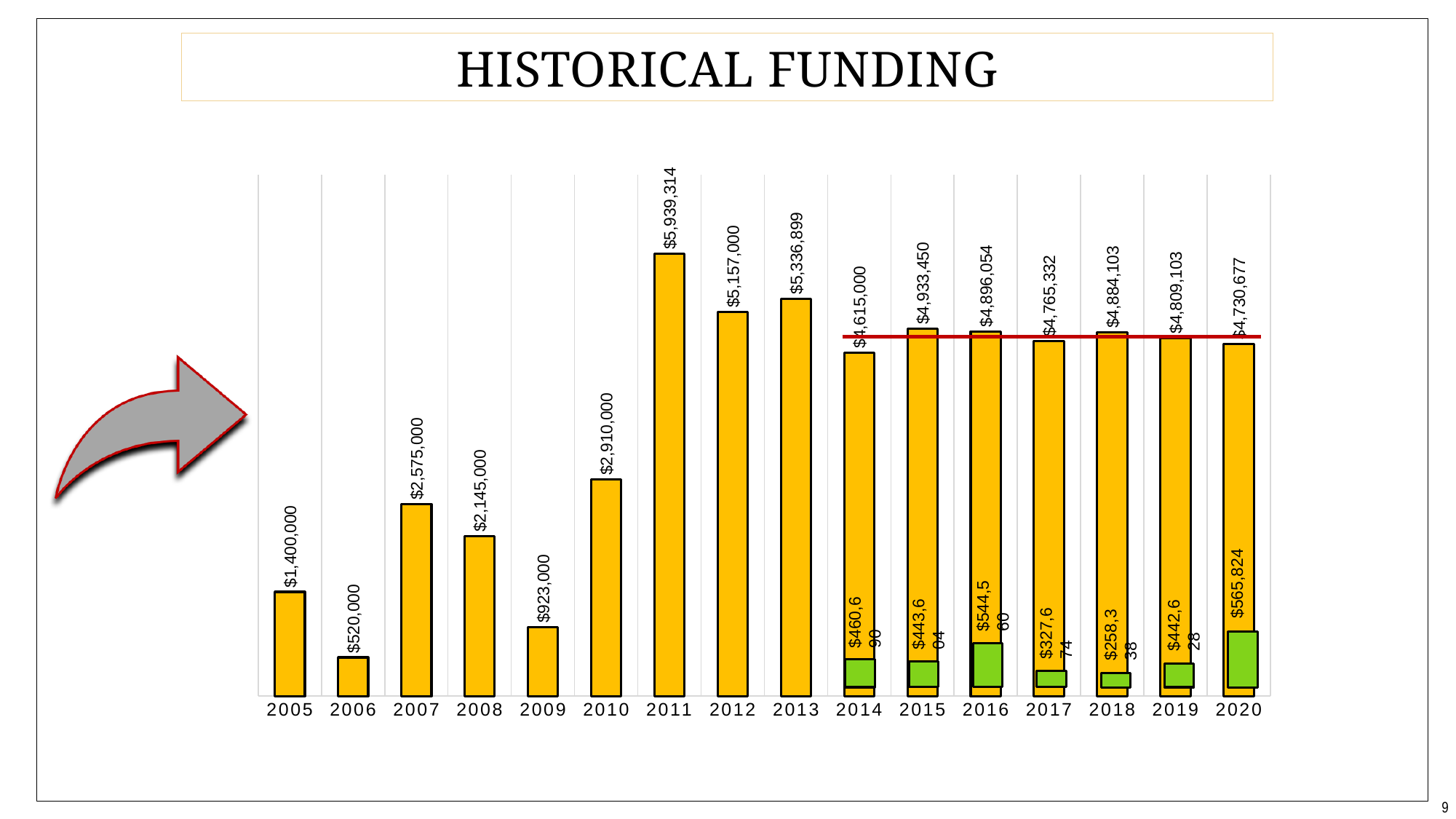
What kind of chart is shown on the slide? bar chart What is the value labelled on the green bar for 2020? $565,824 What is the difference between the funding values for 2011 and 2012? $782,314 What is the funding value shown for 2014? $4,615,000 What is the funding value shown for 2011? $5,939,314 What is the title of the chart? HISTORICAL FUNDING Which year has the larger funding value, 2007 or 2008? 2007 Which year has the lowest funding value? 2006 Do the funding values rise or fall from 2009 to 2011? rise What is the funding value shown for 2006? $520,000 How many years are shown on the x axis of the chart? 16 Which year has the highest funding value? 2011